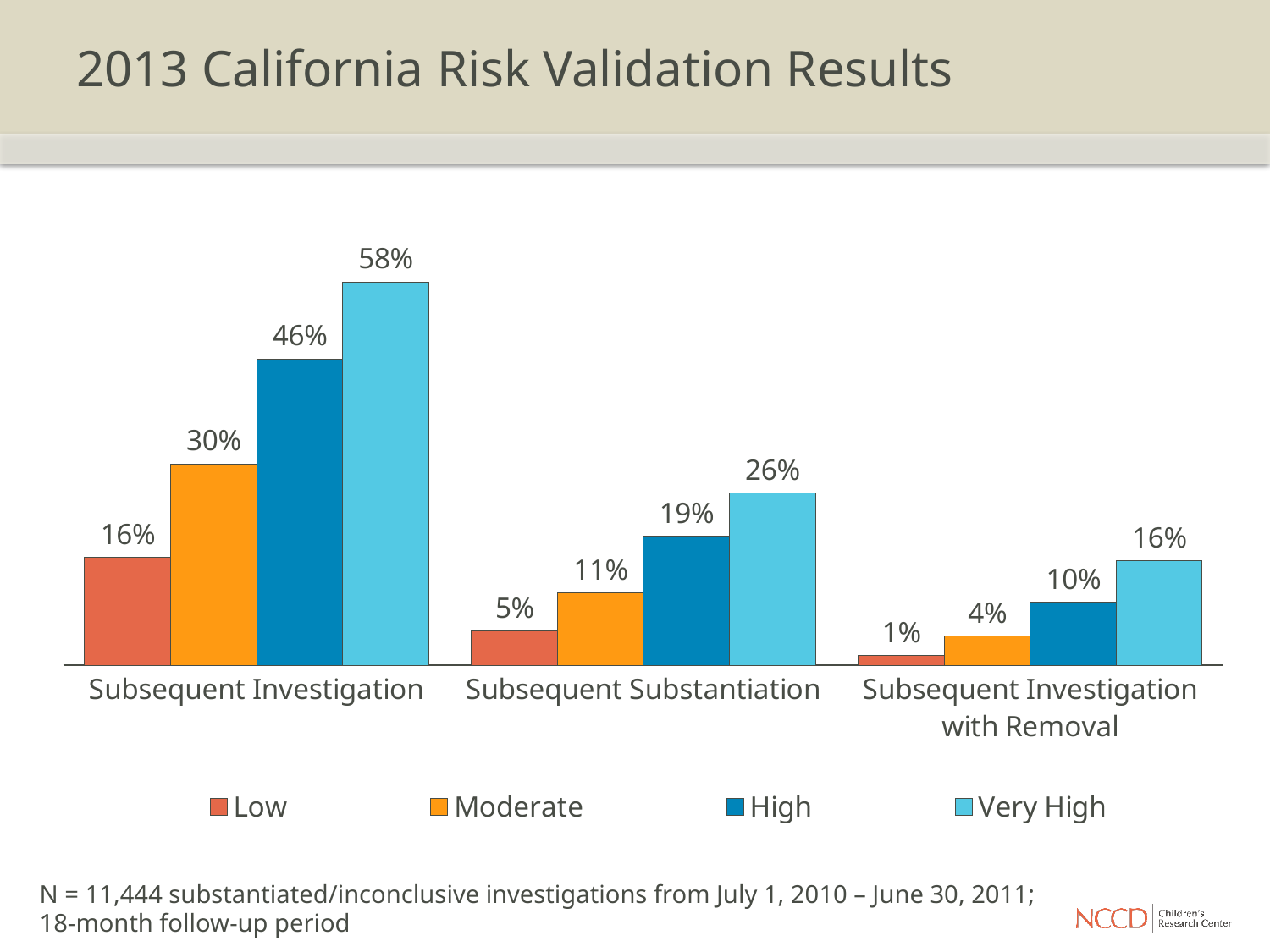
What is the value for Low in the Subsequent Investigation with Removal category? 1% How many series does the legend list? 4 What is the value for Very High in the Subsequent Investigation category? 58% How many categories are shown on the x axis? 3 Within each category, do the values rise or fall from Low to Very High? Rise What is the difference between the Very High and Low values in the Subsequent Investigation category? 42% What is the value for Moderate in the Subsequent Substantiation category? 11% What is the difference between the High and Moderate values in the Subsequent Investigation with Removal category? 6% Which risk level has the highest value in the Subsequent Substantiation category? Very High Which risk level has the lowest value in the Subsequent Investigation category? Low What kind of chart is shown on the slide? Bar chart Which is larger: the High value for Subsequent Substantiation or the Very High value for Subsequent Investigation with Removal? High value for Subsequent Substantiation